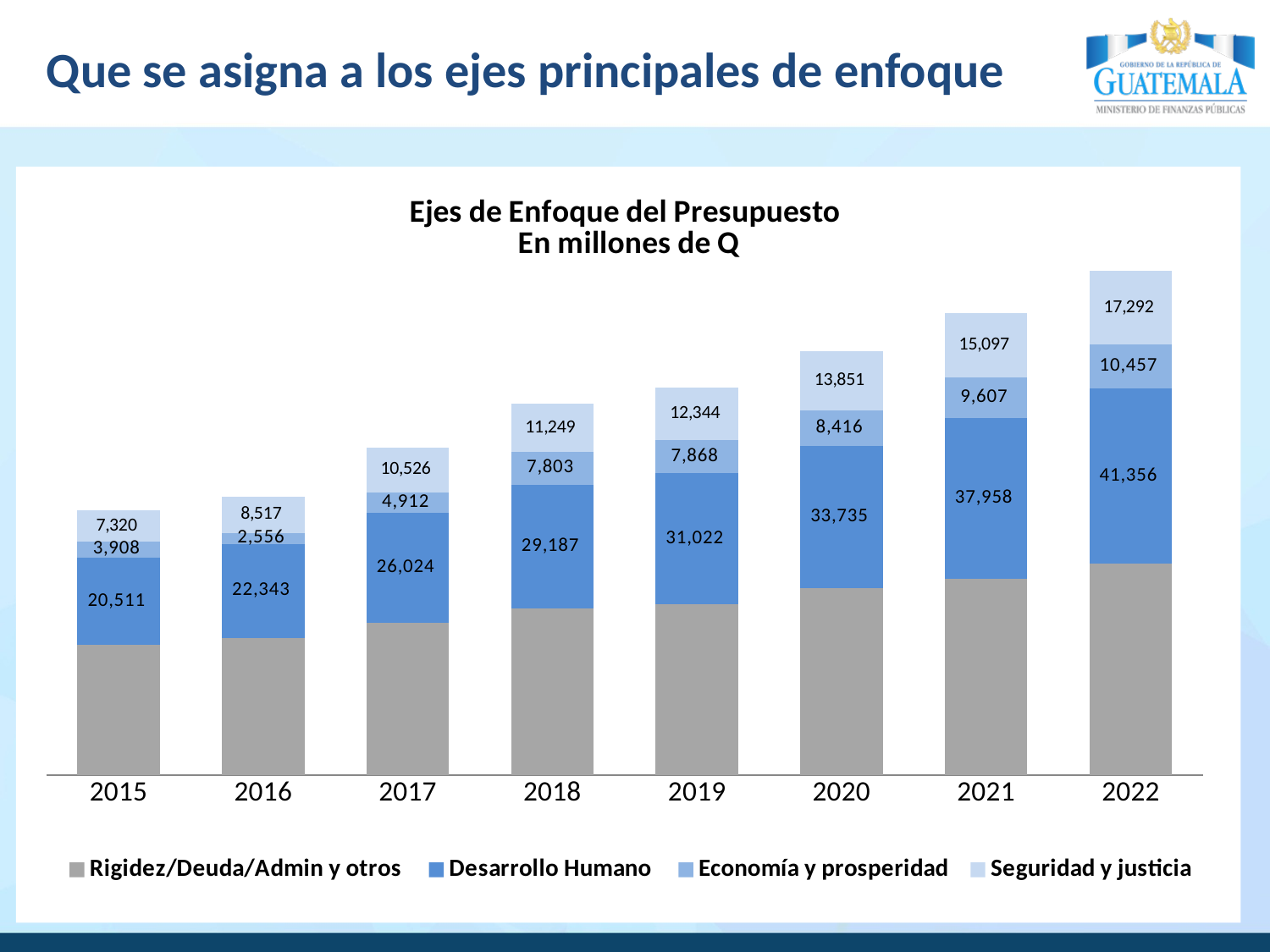
What is the value for Desarrollo Humano in 2018? 29,187 Which is larger: Seguridad y justicia in 2019 or Economía y prosperidad in 2021? Seguridad y justicia in 2019 In which year is the Economía y prosperidad value lowest? 2016 What is the value for Seguridad y justicia in 2022? 17,292 How many series does the legend list? 4 What is the value for Economía y prosperidad in 2016? 2,556 What is the difference between the Desarrollo Humano values for 2022 and 2021? 3,398 What is the title of the chart? Ejes de Enfoque del Presupuesto En millones de Q What kind of chart is shown on the slide? Stacked bar chart Do the Seguridad y justicia values rise or fall from 2015 to 2022? Rise How many years are shown on the x axis? 8 In which year is the Desarrollo Humano value highest? 2022